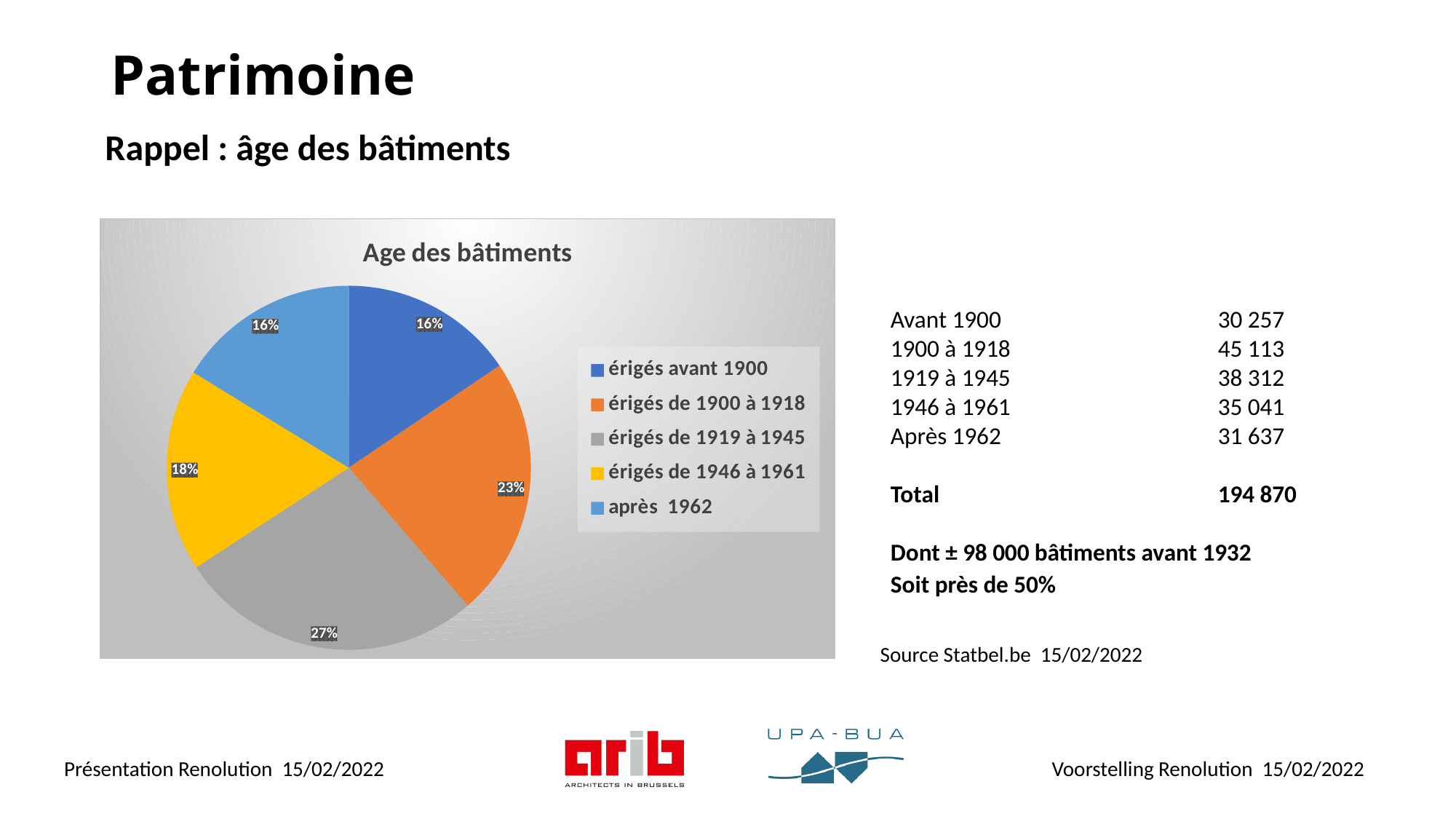
What percentage is shown for 'érigés avant 1900'? 16% How many slices does the pie chart have? 5 What type of chart is shown on the slide? pie chart Which colour represents 'après 1962' in the pie chart? light blue What percentage is shown for 'érigés de 1946 à 1961'? 18% What share of the pie is labelled for 'érigés de 1919 à 1945'? 27% What percentage is shown for 'érigés de 1900 à 1918'? 23% How many entries does the chart legend list? 5 What is the title of the chart? Age des bâtiments Which is larger: the slice for 'érigés de 1900 à 1918' or the slice for 'érigés de 1946 à 1961'? érigés de 1900 à 1918 Which category has the largest slice of the pie? érigés de 1919 à 1945 What is the difference in percentage points between 'érigés de 1919 à 1945' and 'après 1962'? 11